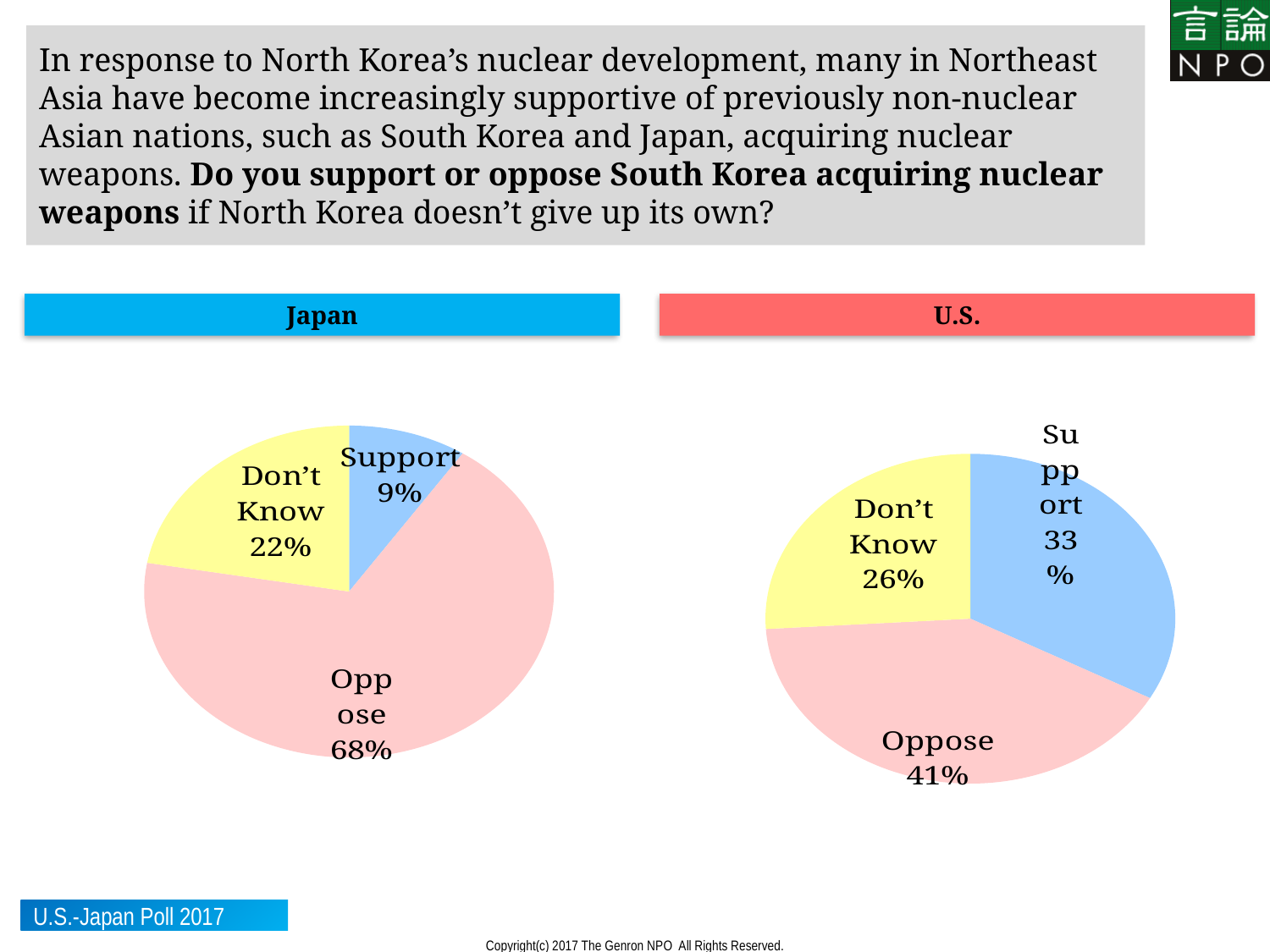
In the U.S. pie chart, what percentage of respondents support South Korea acquiring nuclear weapons? 33% In the Japan pie chart, what percentage of respondents oppose South Korea acquiring nuclear weapons? 68% How many slices does the U.S. pie chart have? 3 In the Japan pie chart, what percentage answered Don't Know? 22% In the Japan pie chart, what colour is the Don't Know slice? Yellow In the U.S. pie chart, what percentage answered Oppose? 41% What type of chart is used to show the Japan results? Pie chart What is the difference between the Oppose share in the Japan chart and the Oppose share in the U.S. chart? 27 percentage points In the U.S. pie chart, which response has the smallest share? Don't Know In the Japan pie chart, which response has the largest share? Oppose In the Japan pie chart, which response has the smallest share? Support Which is larger: the Support share in the Japan chart or the Support share in the U.S. chart? U.S.